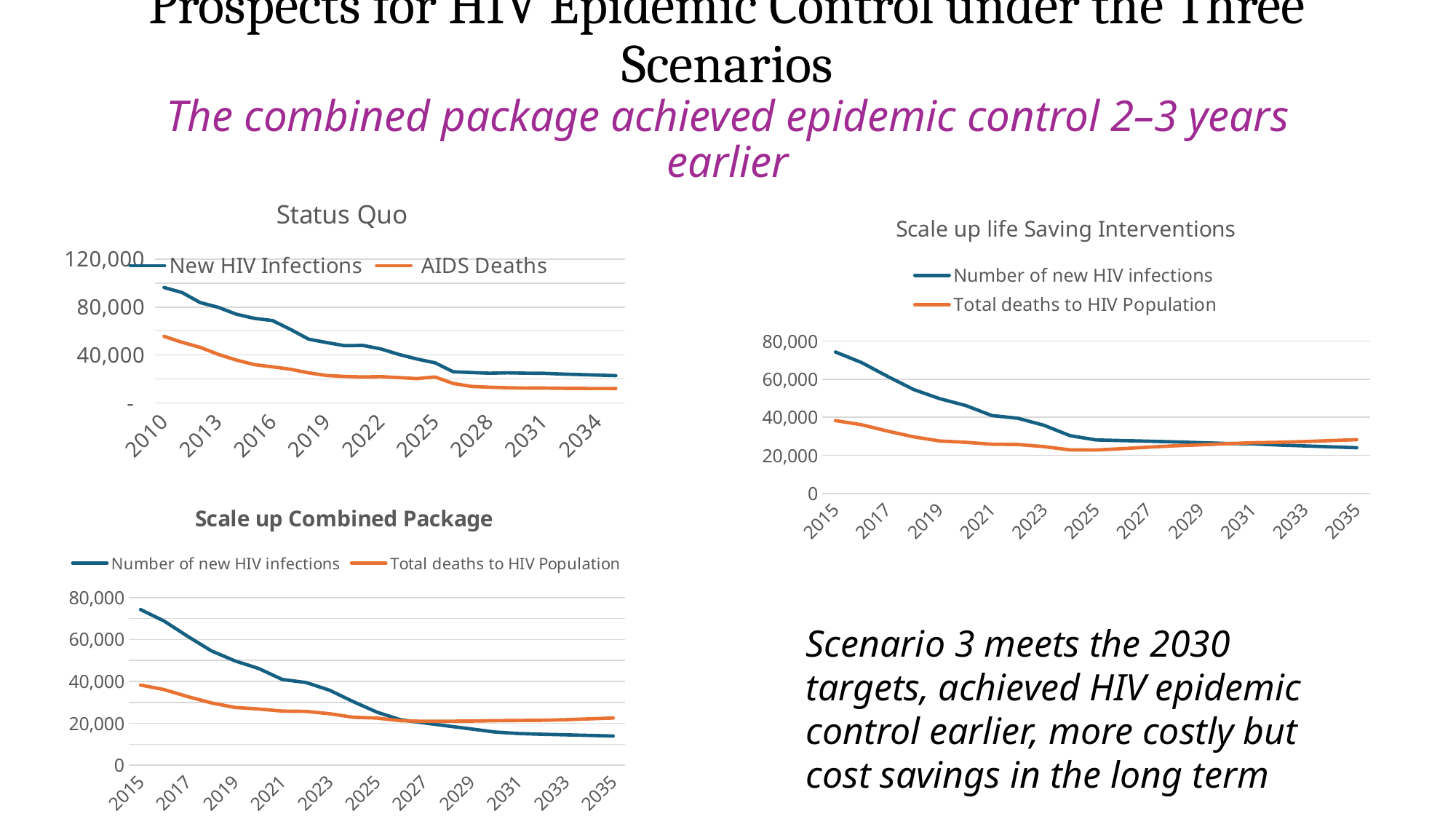
What kind of chart is the 'Status Quo' chart? Line chart In the 'Status Quo' chart, do New HIV Infections rise or fall from 2010 to 2034? Fall In the 'Scale up Combined Package' chart, is the number of new HIV infections in 2035 greater or less than 20,000? less In the 'Scale up life Saving Interventions' chart, which series is larger in 2015: Number of new HIV infections or Total deaths to HIV Population? Number of new HIV infections How many series does the legend of the 'Status Quo' chart list? 2 In the 'Scale up Combined Package' chart, does the number of new HIV infections rise or fall from 2015 to 2035? Fall In the 'Scale up life Saving Interventions' chart, is the number of new HIV infections in 2015 greater or less than 60,000? greater What are the two legend entries in the 'Status Quo' chart? New HIV Infections and AIDS Deaths In the 'Status Quo' chart, is the value for New HIV Infections in 2010 greater or less than 80,000? greater In the 'Scale up Combined Package' chart, which series is larger in 2035: Number of new HIV infections or Total deaths to HIV Population? Total deaths to HIV Population What is the title of the chart in the bottom-left of the slide? Scale up Combined Package